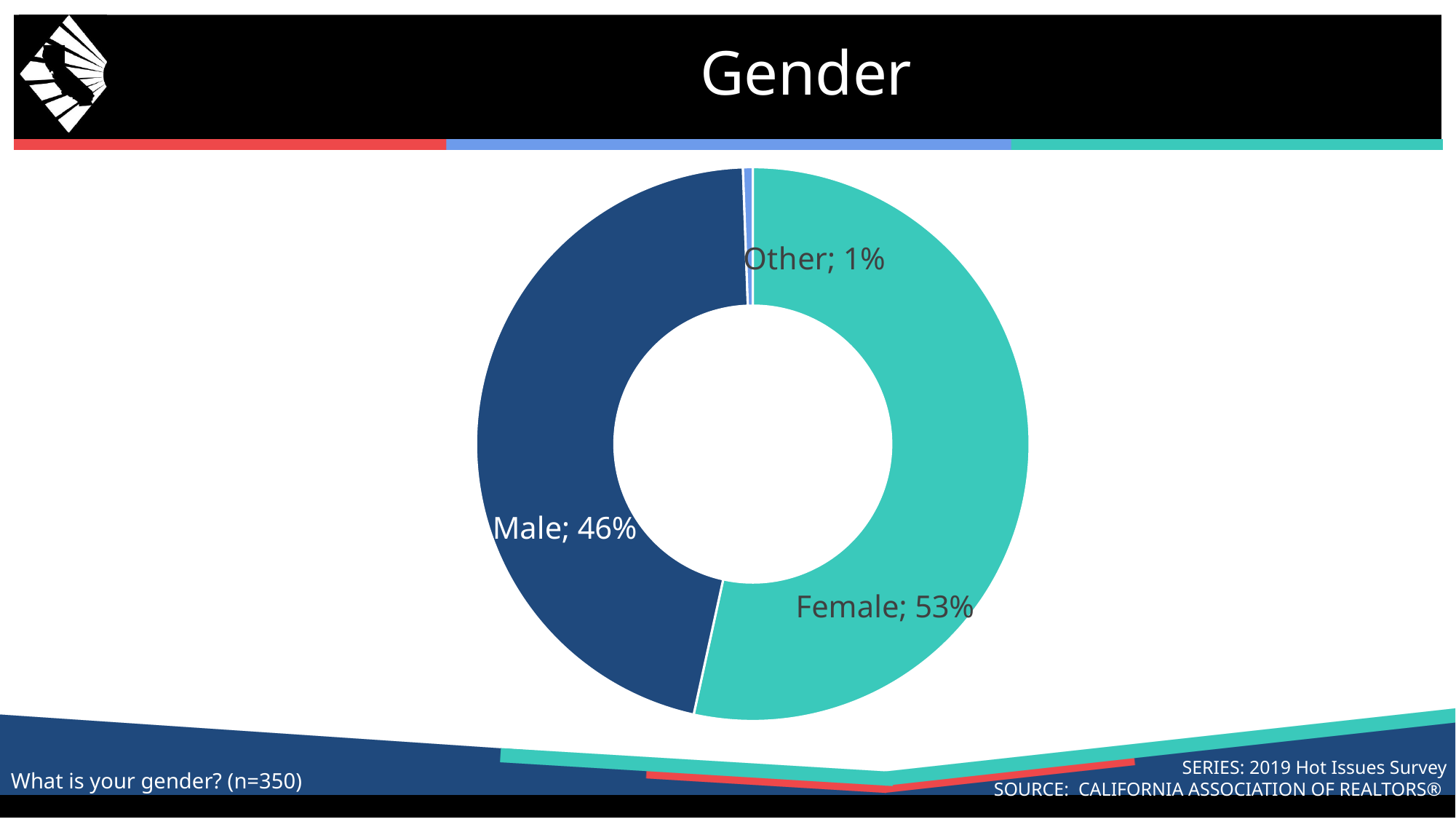
What is the difference in percentage points between Female and Male? 7 What percentage of respondents are Female? 53% Which gender category has the smallest share? Other What percentage of respondents answered Other? 1% What kind of chart is shown on the slide? Pie chart (doughnut) What is the title of the slide? Gender What percentage of respondents are Male? 46% How many categories are shown in the chart? 3 Which gender category has the largest share? Female Which is larger, the Male share or the Female share? Female What is the difference in percentage points between Male and Other? 45 What is the sample size (n) stated on the slide? 350